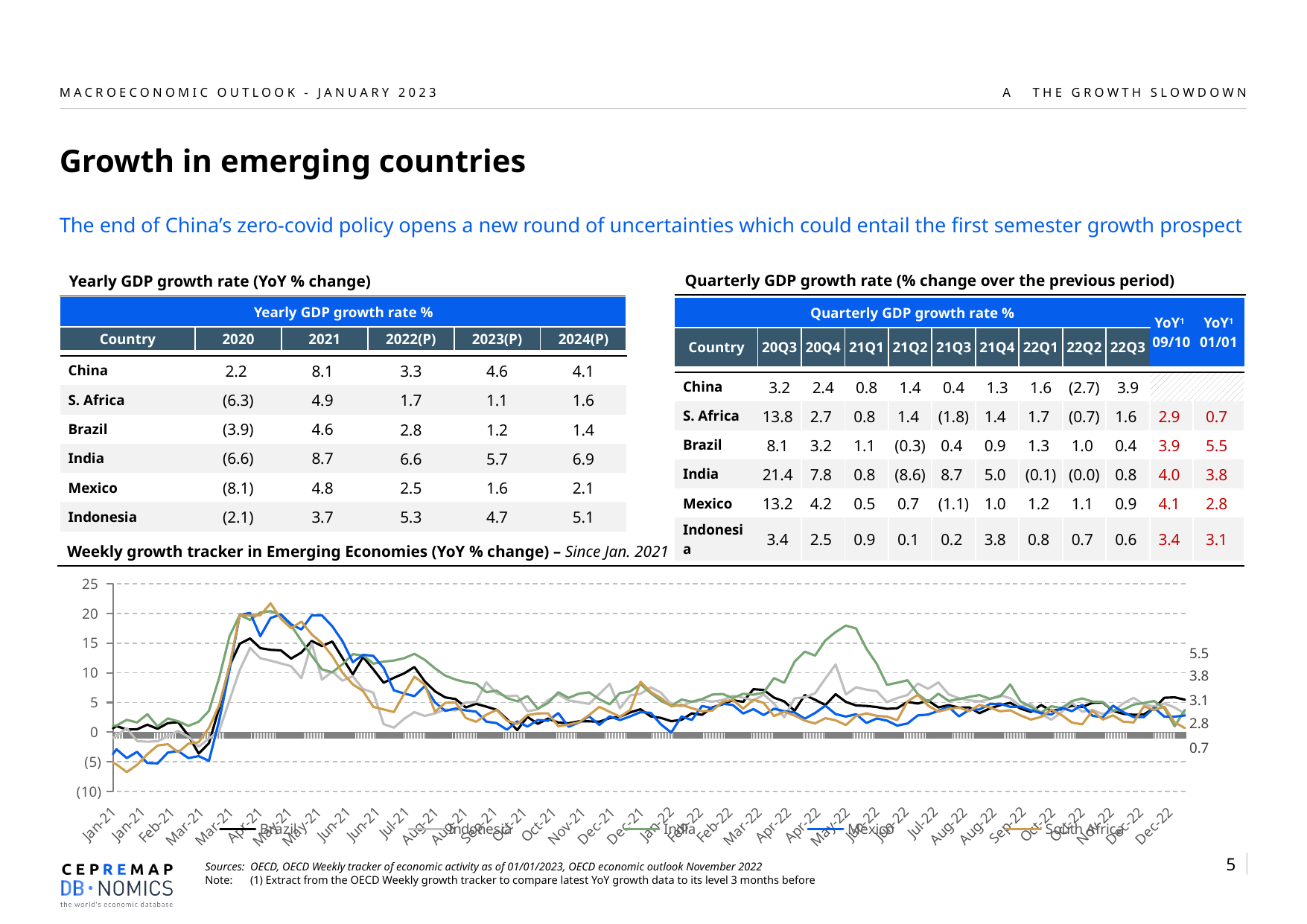
In the weekly growth tracker chart, is the peak of the India line around May-22 greater or less than 15? greater In the weekly growth tracker chart, is the latest labelled value larger for Brazil or for Mexico? Brazil In the weekly growth tracker chart, which country has the lowest latest value at the right end of the chart? South Africa In the weekly growth tracker chart, what is the difference between the latest labelled values for Brazil and South Africa? 4.8 How many series does the legend of the weekly growth tracker chart list? 5 In the weekly growth tracker chart, what is the latest value labelled at the end of the Brazil line? 5.5 What is the highest value shown on the y axis of the weekly growth tracker chart? 25 What kind of chart is the weekly growth tracker chart at the bottom of the slide? line chart In the weekly growth tracker chart, which country has the highest latest value at the right end of the chart? Brazil In the weekly growth tracker chart, what is the latest value labelled at the end of the South Africa line? 0.7 In the weekly growth tracker chart, does the India line rise or fall between Apr-21 and Oct-21? fall In the weekly growth tracker chart, is the value for Mexico in Jan-21 greater or less than 0? less